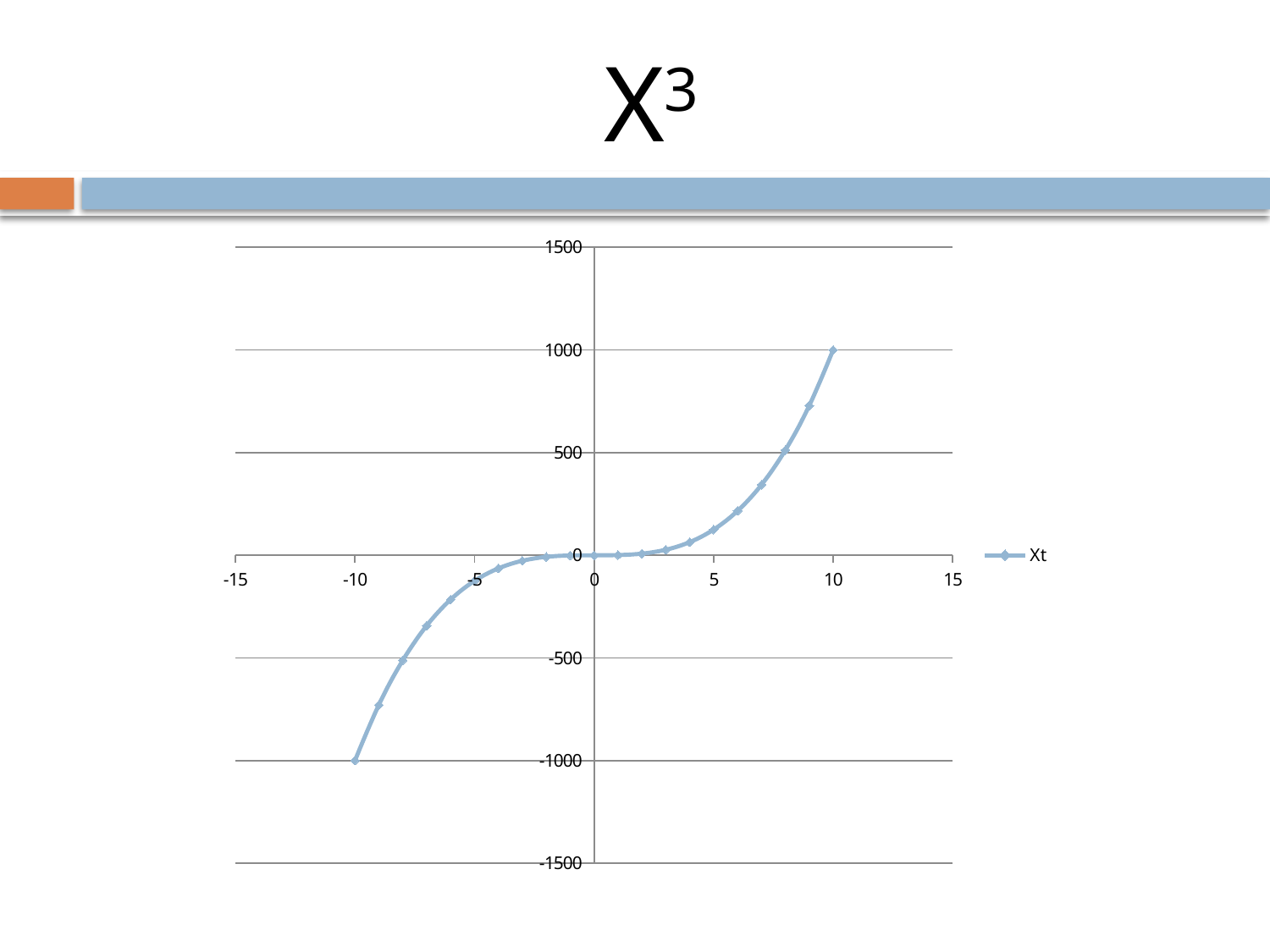
How many series does the legend list? 1 What is the value of Xt at x = -10? -1000 What is the value of Xt at x = 10? 1000 Is the value of Xt at x = 9 greater or less than 500? greater Do the values of Xt rise or fall as x increases from -10 to 10? rise At which x value does Xt reach its highest value? 10 What is the name of the series shown in the legend? Xt At which x value does Xt reach its lowest value? -10 What is the title of the slide containing the chart? X³ Is the value of Xt at x = 5 greater or less than 500? less What kind of chart is shown on the slide? line chart What is the difference between the value of Xt at x = 10 and at x = -10? 2000